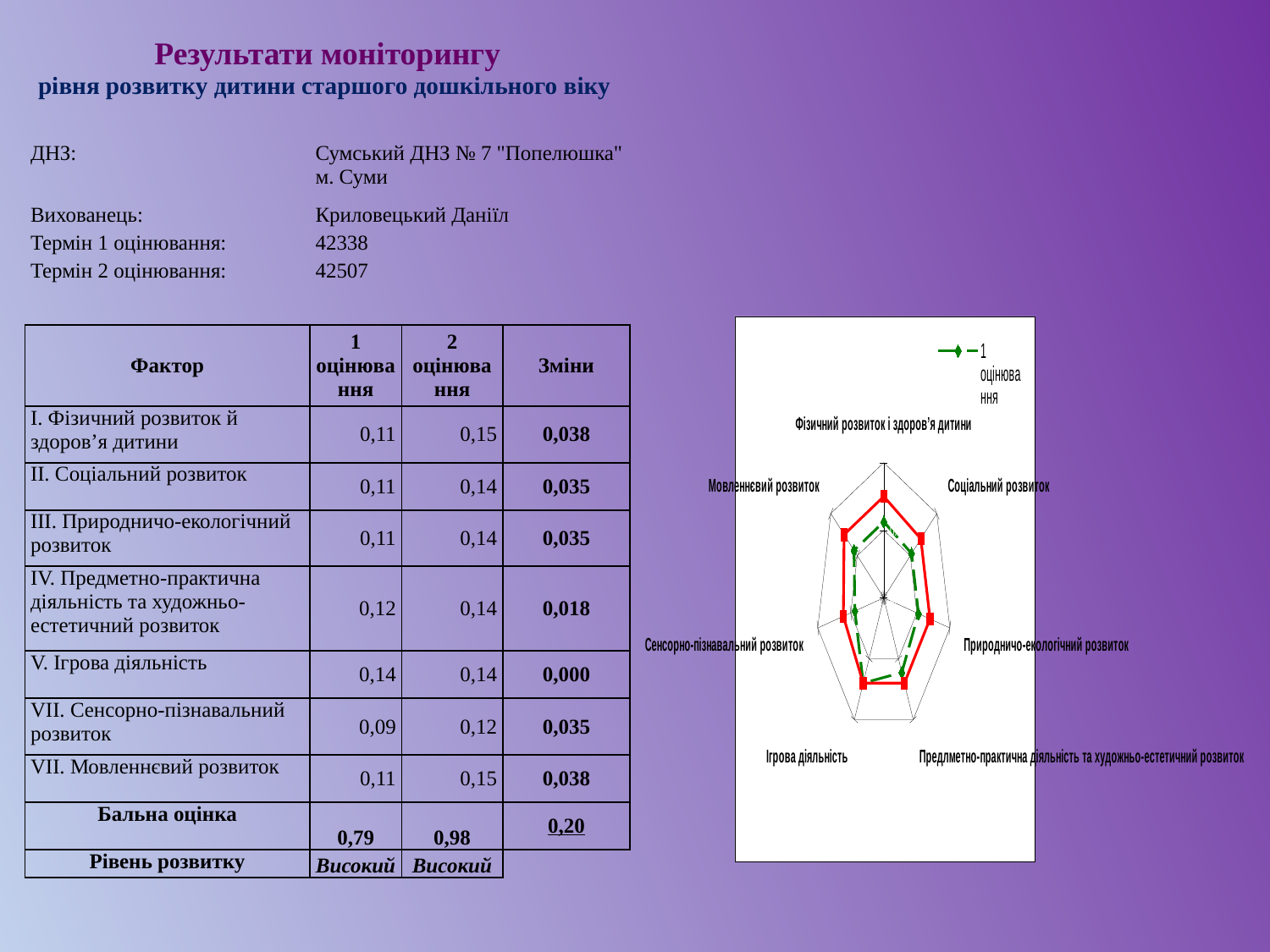
On the radar chart, which series lies farther from the centre for Фізичний розвиток і здоров'я дитини: the green dashed series or the red solid series? The red solid series On the radar chart, which series lies farther from the centre for Сенсорно-пізнавальний розвиток: the green dashed series or the red solid series? The red solid series What kind of chart is shown on the right side of the slide? Radar chart Which category label sits at the top of the radar chart? Фізичний розвиток і здоров'я дитини On the radar chart, which series lies farther from the centre for Мовленнєвий розвиток: the green dashed series or the red solid series? The red solid series Which series name is readable in the radar chart's legend? 1 оцінювання How many data series are plotted on the radar chart? 2 How many categories (axes) does the radar chart have? 7